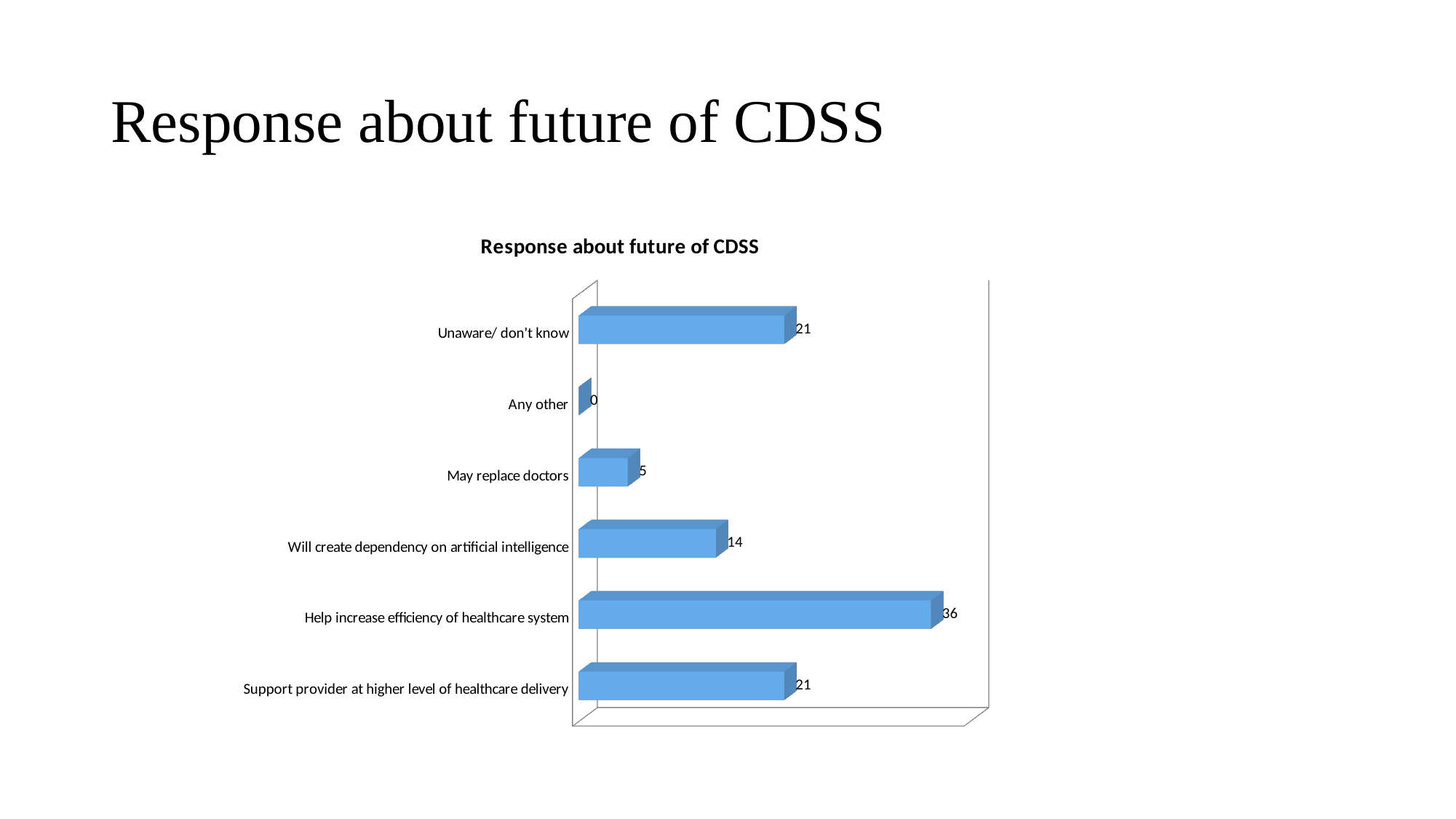
Which category has the lowest value? Any other What kind of chart is shown on the slide? Bar chart What is the value for "Help increase efficiency of healthcare system"? 36 What is the title of the chart? Response about future of CDSS What is the difference between the values for "Help increase efficiency of healthcare system" and "Will create dependency on artificial intelligence"? 22 What is the value for "Any other"? 0 Which is larger: the value for "May replace doctors" or the value for "Will create dependency on artificial intelligence"? Will create dependency on artificial intelligence What is the value for "Will create dependency on artificial intelligence"? 14 What is the value for "May replace doctors"? 5 Which category has the highest value? Help increase efficiency of healthcare system How many categories are shown in the chart? 6 What is the value for "Unaware/ don't know"? 21